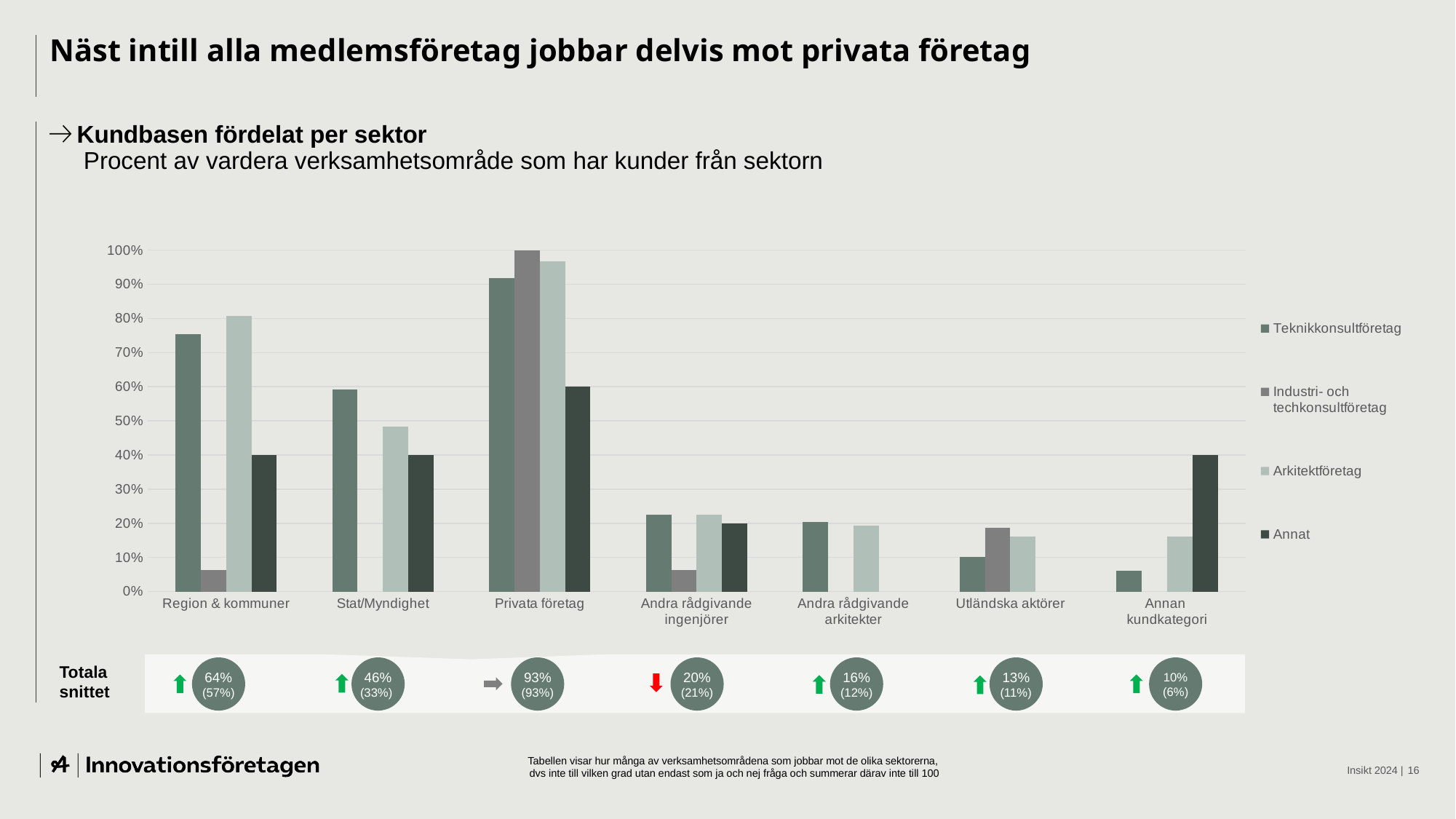
What is the value for Industri- och techkonsultföretag in the Privata företag category? 100% How many sector categories are shown on the x axis? 7 What is the total average (Totala snittet) shown for Privata företag? 93% Is the value for Teknikkonsultföretag in Stat/Myndighet greater or less than 50%? greater What is the value for Annat in the Privata företag category? 60% What is the total average (Totala snittet) shown for Utländska aktörer? 13% Which is larger in the Annan kundkategori category: Annat or Arkitektföretag? Annat How many series does the legend list? 4 What kind of chart is shown on the slide? bar chart What is the value for Annat in the Region & kommuner category? 40% Is the value for Arkitektföretag in Region & kommuner greater or less than 70%? greater Which sector has the highest bars overall? Privata företag